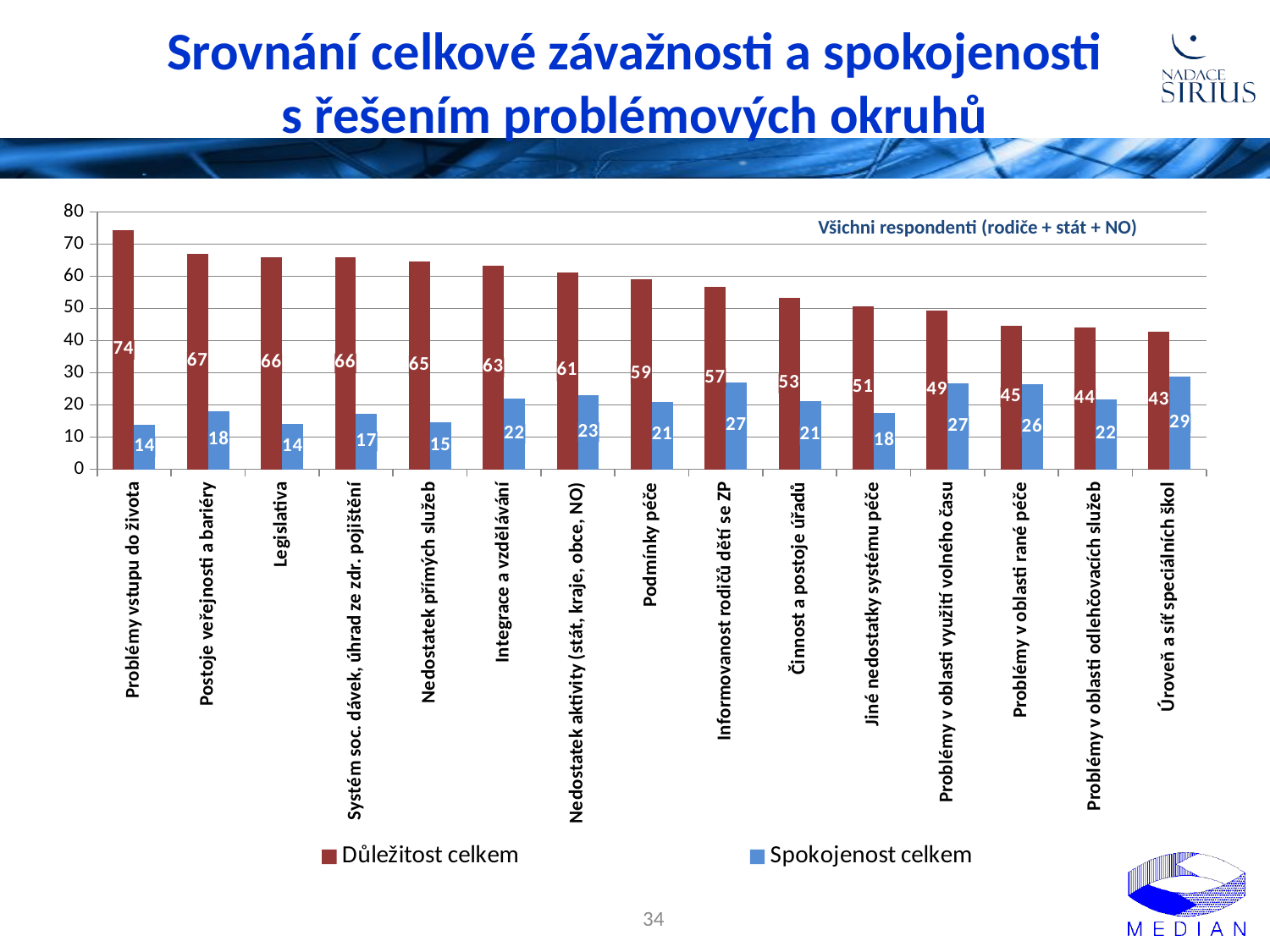
Which category has the highest Důležitost celkem value? Problémy vstupu do života What kind of chart is shown on the slide? Bar chart Which category has the highest Spokojenost celkem value? Úroveň a síť speciálních škol What is the Důležitost celkem value for Legislativa? 66 How many categories are shown on the x axis? 15 What is the Spokojenost celkem value for Informovanost rodičů dětí se ZP? 27 Which category has the lowest Důležitost celkem value? Úroveň a síť speciálních škol Which is larger: the Spokojenost celkem value for Integrace a vzdělávání or for Podmínky péče? Integrace a vzdělávání How many series does the legend list? 2 What is the Spokojenost celkem value for Nedostatek přímých služeb? 15 Do the Důležitost celkem values rise or fall from left to right along the x axis? Fall What is the difference between the Důležitost celkem and Spokojenost celkem values for Problémy vstupu do života? 60